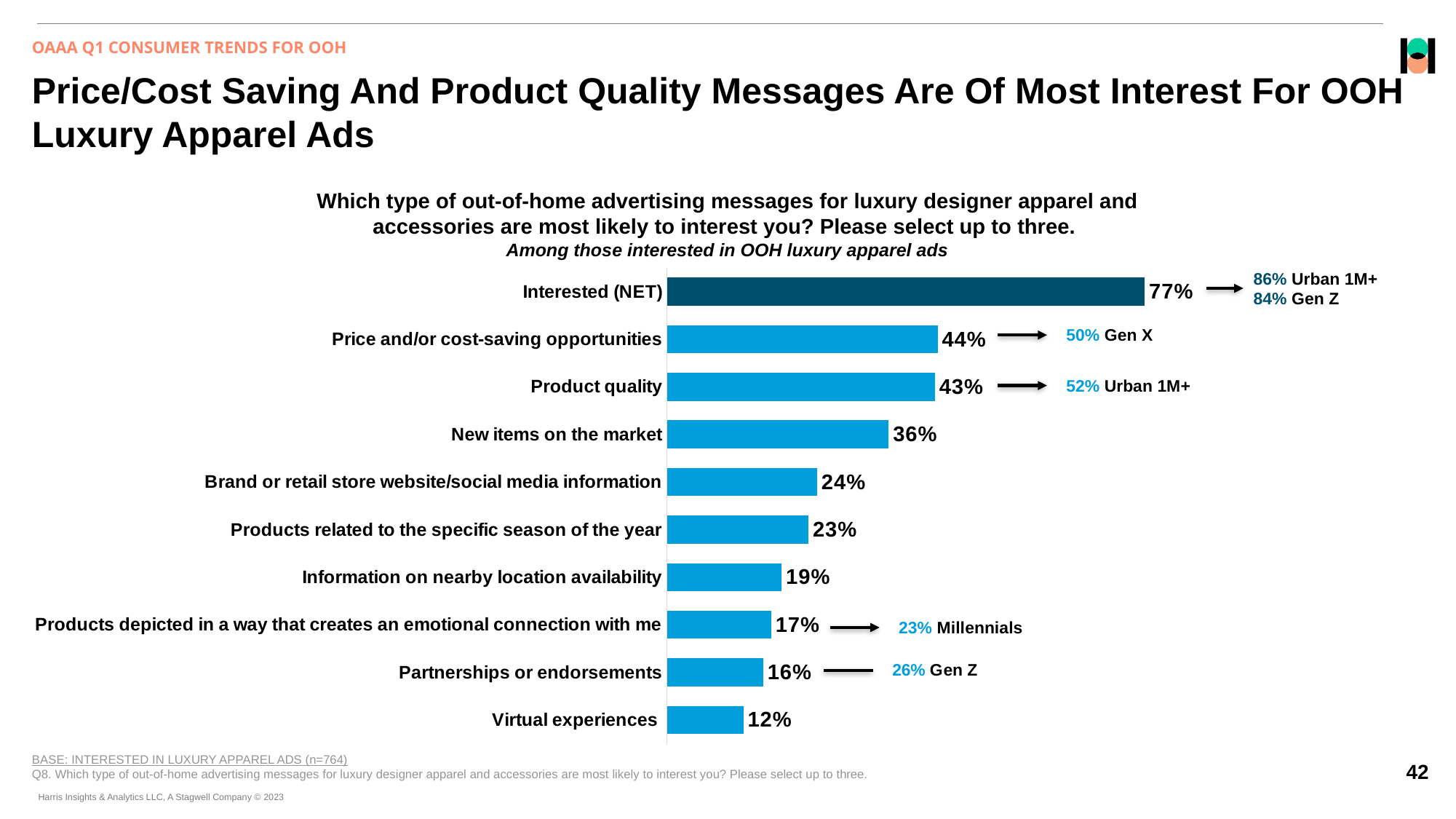
What percentage is shown for Virtual experiences? 12% What percentage is shown for Price and/or cost-saving opportunities? 44% What kind of chart is shown on the slide? Bar chart Excluding the Interested (NET) bar, which message type has the highest percentage? Price and/or cost-saving opportunities What is the value for Interested (NET)? 77% Which is larger: Information on nearby location availability or Products related to the specific season of the year? Products related to the specific season of the year What percentage of Millennials is shown in the callout for Products depicted in a way that creates an emotional connection with me? 23% What percentage of Gen X selected Price and/or cost-saving opportunities, according to the callout? 50% What is the value for Product quality? 43% What is the difference between New items on the market and Partnerships or endorsements? 20% Which message type has the lowest percentage? Virtual experiences How many bars are plotted in the chart, including Interested (NET)? 10